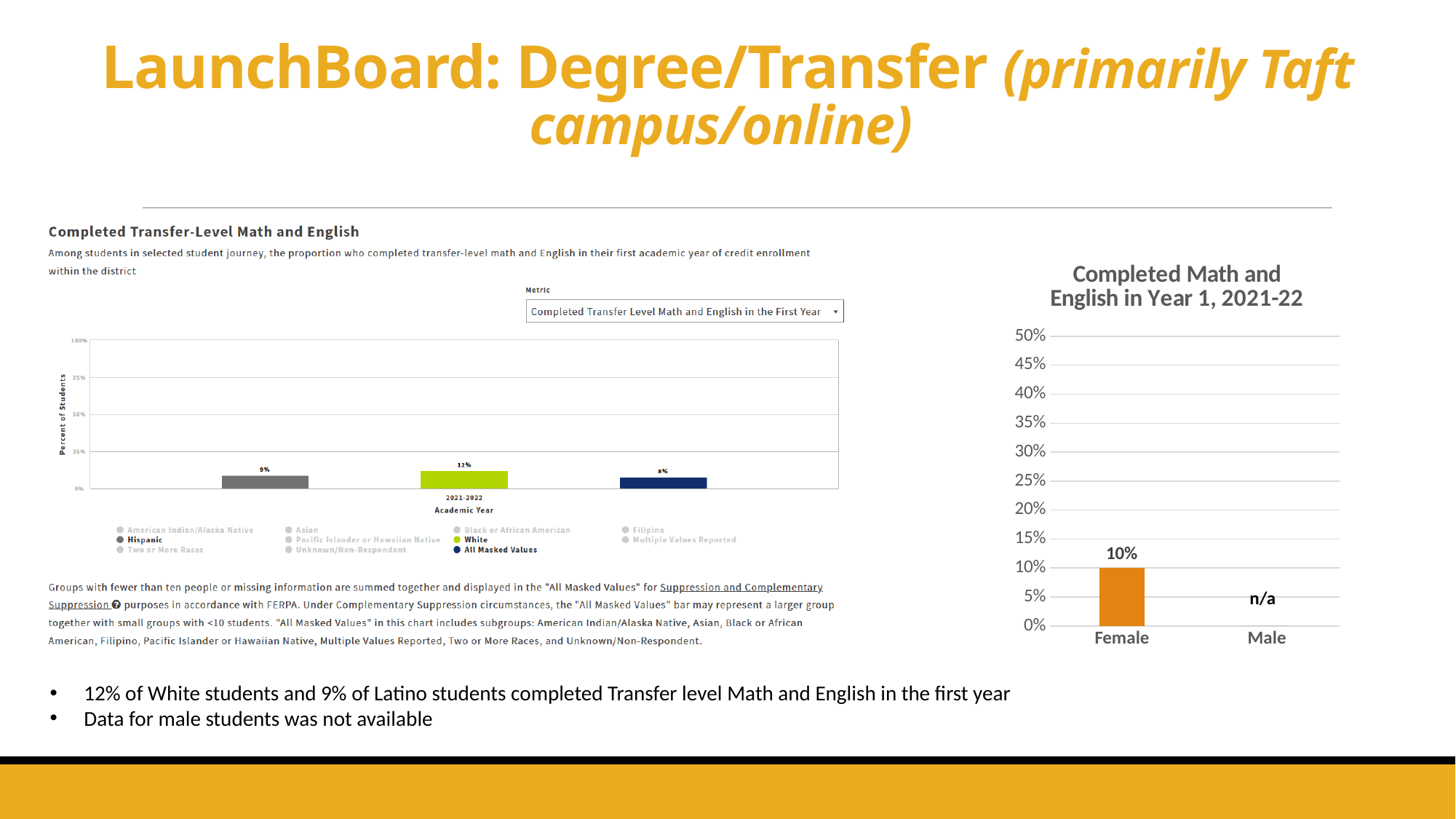
In the 'Completed Transfer-Level Math and English' chart, is the value for White students greater or less than 25%? less In the 'Completed Transfer-Level Math and English' chart, what is the value for Hispanic students? 9% What kind of chart is the 'Completed Math and English in Year 1, 2021-22' chart? Bar chart In the 'Completed Transfer-Level Math and English' chart, what is the value for White students? 12% In the 'Completed Transfer-Level Math and English' chart, what is the value for All Masked Values? 8% In the 'Completed Transfer-Level Math and English' chart, which group has the lowest value? All Masked Values In the 'Completed Math and English in Year 1, 2021-22' chart, what is shown for Male? n/a How many categories are on the x axis of the 'Completed Math and English in Year 1, 2021-22' chart? 2 In the 'Completed Math and English in Year 1, 2021-22' chart, what is the highest value shown on the vertical axis? 50% In the 'Completed Math and English in Year 1, 2021-22' chart, what is the value for Female? 10% In the 'Completed Transfer-Level Math and English' chart, what is the difference between the White and Hispanic values? 3% In the 'Completed Transfer-Level Math and English' chart, which group has the highest value? White